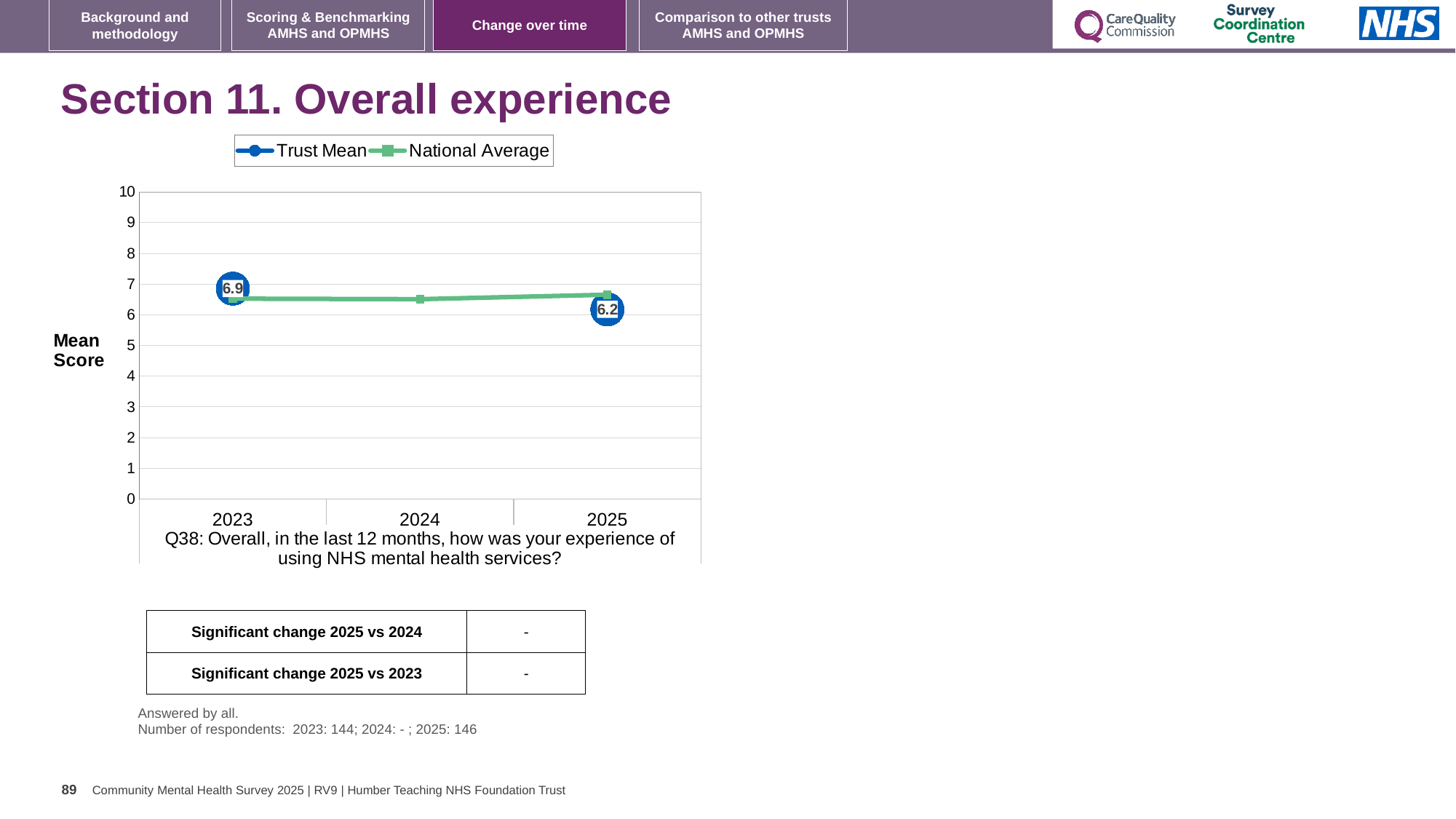
How many years are shown on the x axis of the chart? 3 Is the National Average value for 2025 greater or less than 7? less Is the National Average value for 2024 greater or less than 6? greater What is the Trust Mean value for 2025? 6.2 In 2023, which is higher, the Trust Mean or the National Average? Trust Mean How many series does the chart legend list? 2 Which year has the higher Trust Mean, 2023 or 2025? 2023 Does the Trust Mean rise or fall from 2023 to 2025? fall What kind of chart is shown on the slide? line chart What is the difference between the Trust Mean in 2023 and the Trust Mean in 2025? 0.7 What is the Trust Mean value for 2023? 6.9 In 2025, which is higher, the Trust Mean or the National Average? National Average